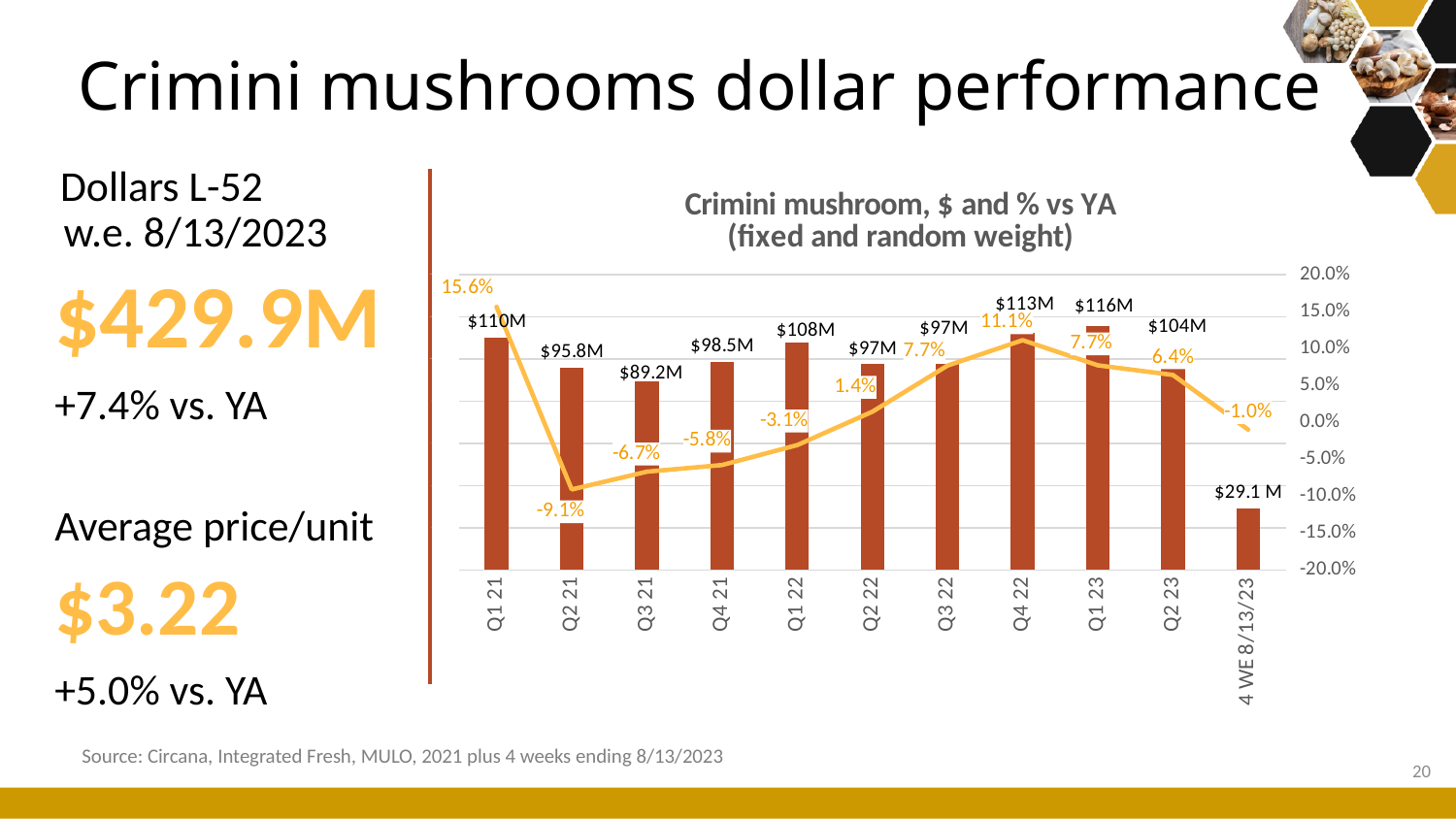
What is the dollar value shown for Q3 21? $89.2M Which is larger, the dollar value for Q1 21 or for Q1 22? Q1 21 How many periods are shown on the x axis of the chart? 11 What is the % vs YA value shown for Q2 21 in the chart? -9.1% Which quarter has the highest dollar value among the quarterly bars? Q1 23 What is the title of the chart? Crimini mushroom, $ and % vs YA (fixed and random weight) Does the % vs YA line rise or fall from Q2 21 to Q4 22? Rise What is the % vs YA value shown for Q4 22? 11.1% Which period has the lowest % vs YA value on the line? Q2 21 What kind of chart is shown on the slide? Combination bar and line chart What is the dollar value shown for Q1 23 in the chart? $116M What is the difference in dollar value between Q1 23 and Q2 23? $12M